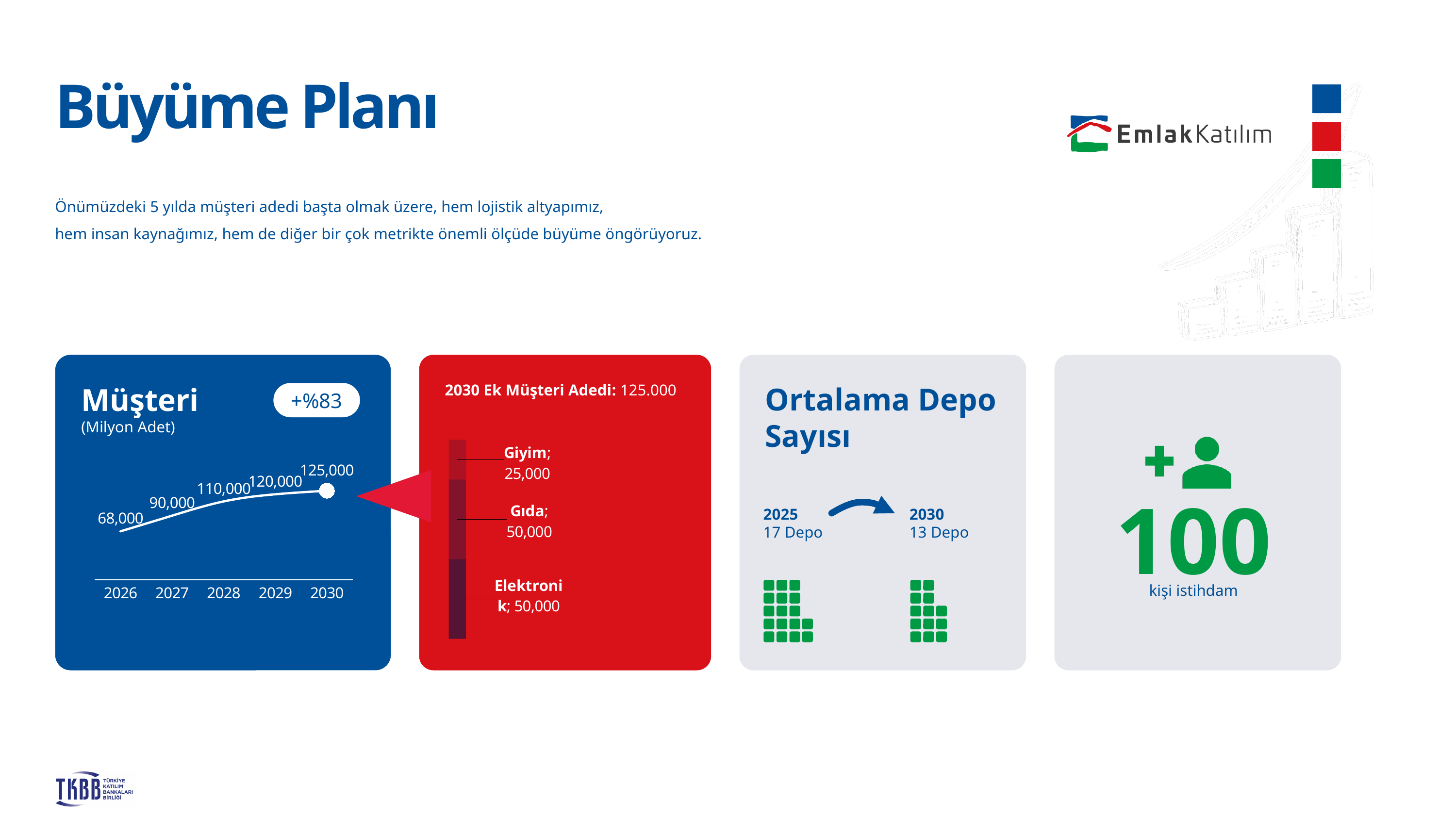
What kind of chart is the Müşteri chart in the blue panel? line chart On the Müşteri line chart, which year has the highest value? 2030 On the Müşteri line chart, how many years are plotted on the x axis? 5 On the Müşteri line chart, what is the difference between the 2027 and 2026 values? 22,000 On the stacked bar chart in the red panel, which of Giyim or Gıda has the larger value? Gıda On the Müşteri line chart, what is the value for 2030? 125,000 On the Müşteri line chart, what is the value for 2028? 110,000 On the Müşteri line chart, what is the value for 2026? 68,000 On the stacked bar chart in the red panel, what is the total of the three segments (Giyim, Gıda, Elektronik)? 125,000 On the stacked bar chart in the red panel, what is the value for Giyim? 25,000 On the Müşteri line chart, which year has the lowest value? 2026 On the Müşteri line chart, do the values rise or fall from 2026 to 2030? rise